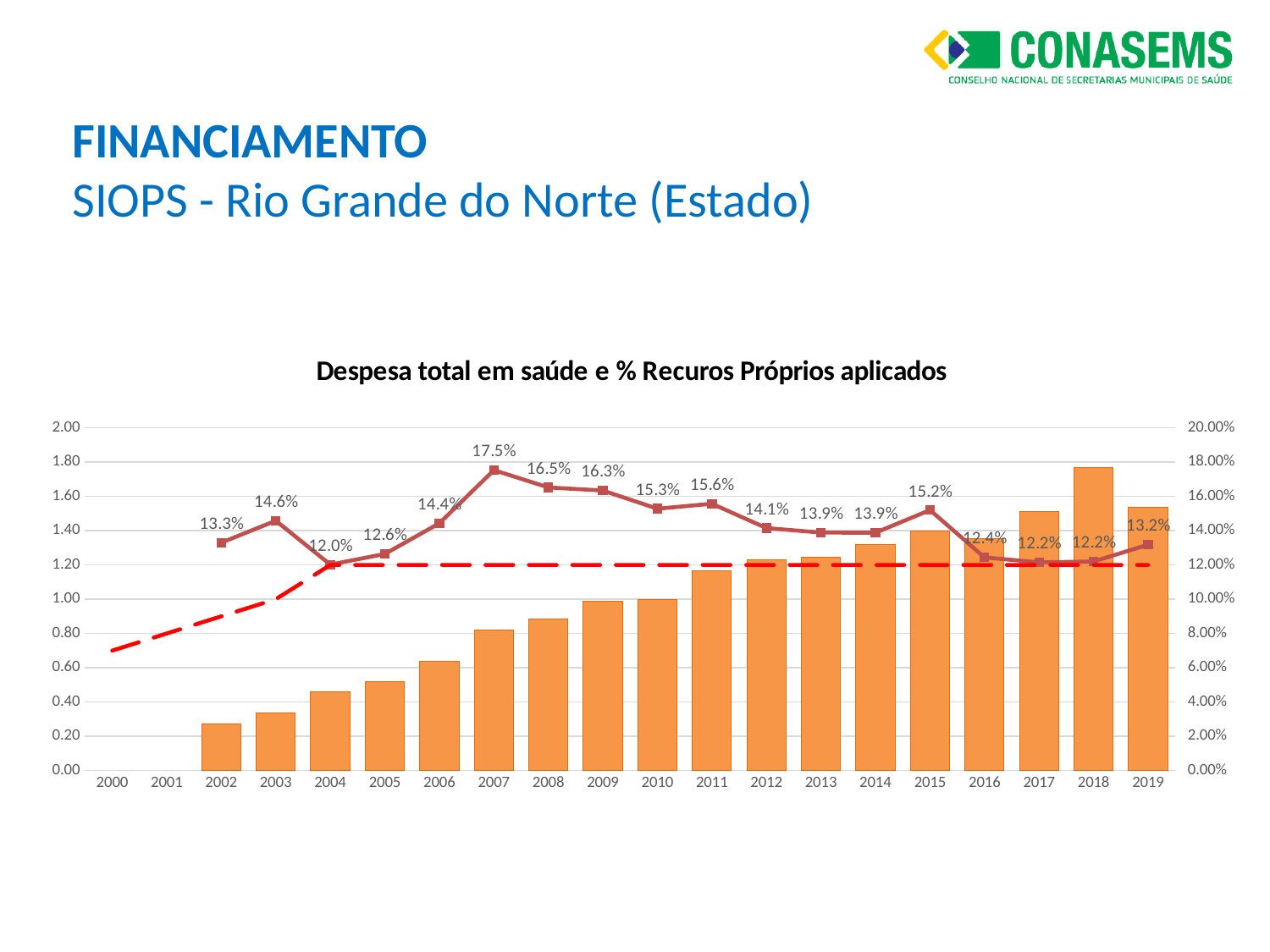
What is the % Recursos Próprios value shown for 2019? 13.2% What kind of chart is shown on the slide? Combined bar and line chart What is the difference between the % Recursos Próprios values for 2007 and 2004? 5.5 percentage points In which year does the % Recursos Próprios line show its lowest labelled value? 2004 Is the bar value for 2018 greater or less than 1.60? greater Which year has the tallest bar for despesa total em saúde? 2018 In which year does the % Recursos Próprios line reach its highest value? 2007 Is the bar value for 2002 greater or less than 0.40? less Do the bars for despesa total em saúde generally rise or fall from 2002 to 2018? rise How many years are listed on the x axis of the chart? 20 What is the % Recursos Próprios value shown for 2007? 17.5% Which year has the higher % Recursos Próprios value, 2003 or 2006? 2003